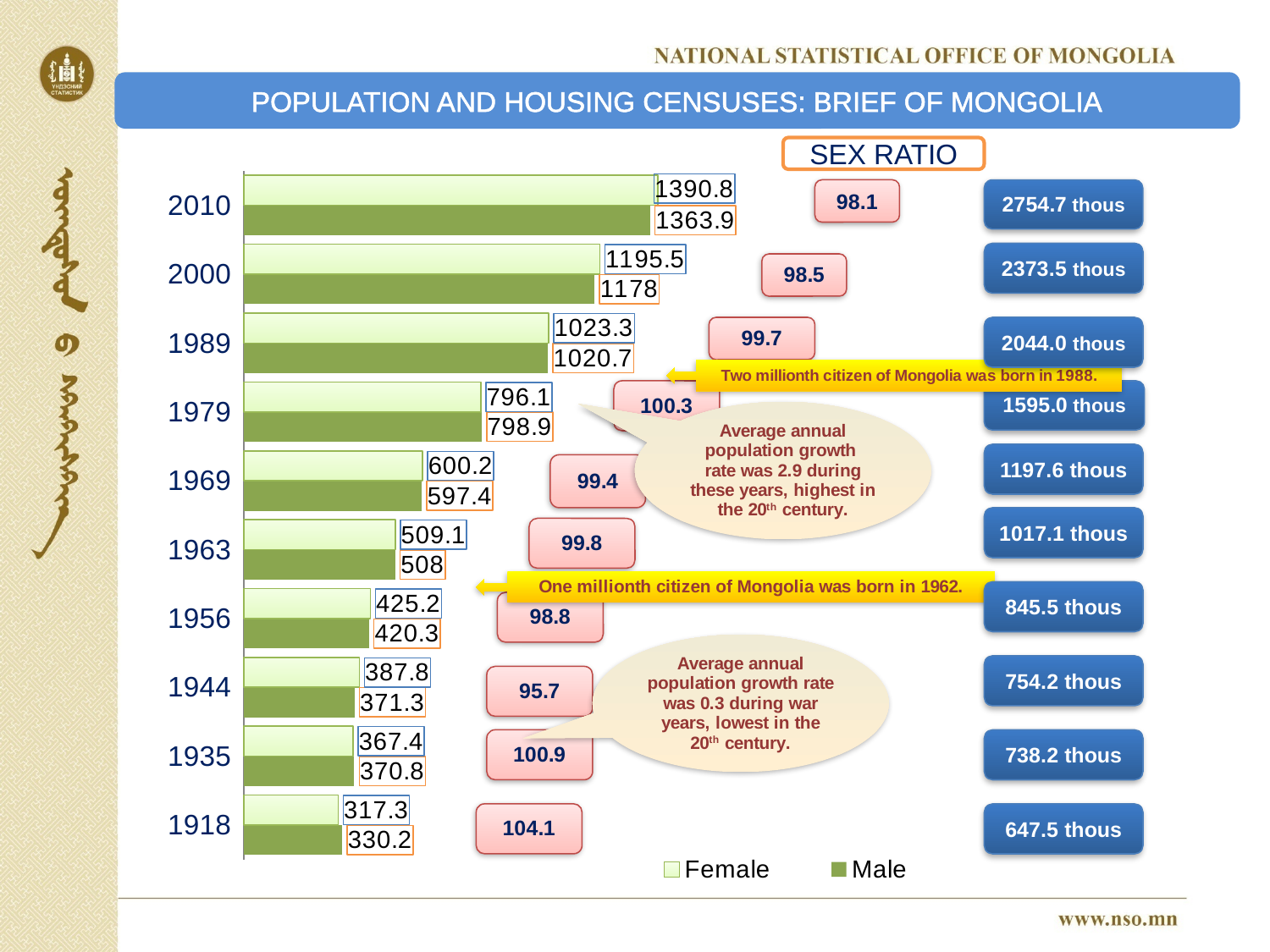
What is the difference between the Female and Male values for 2010? 26.9 Do the Female values rise or fall from 1918 to 2010? Rise Which year has the lowest Male value? 1918 What is the difference between the Female and Male values for 1944? 16.5 What is the Male value for 1918? 330.2 What kind of chart is shown on the slide? Bar chart How many census years are shown in the chart? 10 What is the Female value for 2010? 1390.8 For 1979, which is larger, the Female value or the Male value? Male What is the Male value for 2000? 1178 How many series does the legend list? 2 Which year has the highest Female value? 2010